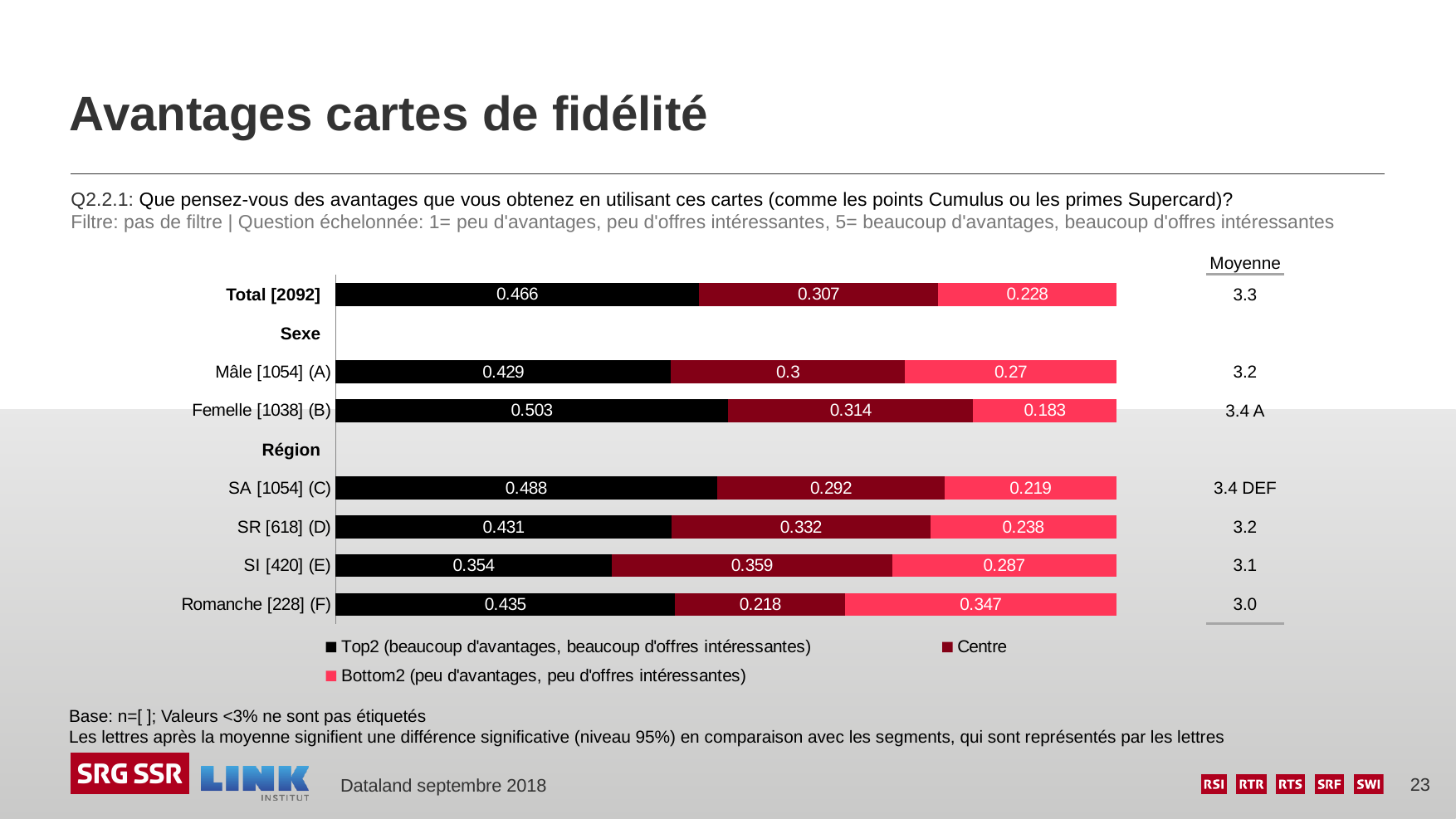
Which category has the highest Top2 value? Femelle [1038] (B) What is the Centre value for SI [420] (E)? 0.359 What kind of chart is shown on the slide? Stacked bar chart How many categories have bars plotted in the chart? 7 Which has a larger Bottom2 value, Mâle [1054] (A) or Femelle [1038] (B)? Mâle [1054] (A) What is the Moyenne shown for SA [1054] (C)? 3.4 DEF Which category has the lowest Top2 value? SI [420] (E) What is the Top2 value for Femelle [1038] (B)? 0.503 How many series does the legend list? 3 What is the difference between the Top2 values for Femelle [1038] (B) and Mâle [1054] (A)? 0.074 What is the Bottom2 value for Romanche [228] (F)? 0.347 Which category has the lowest Centre value? Romanche [228] (F)